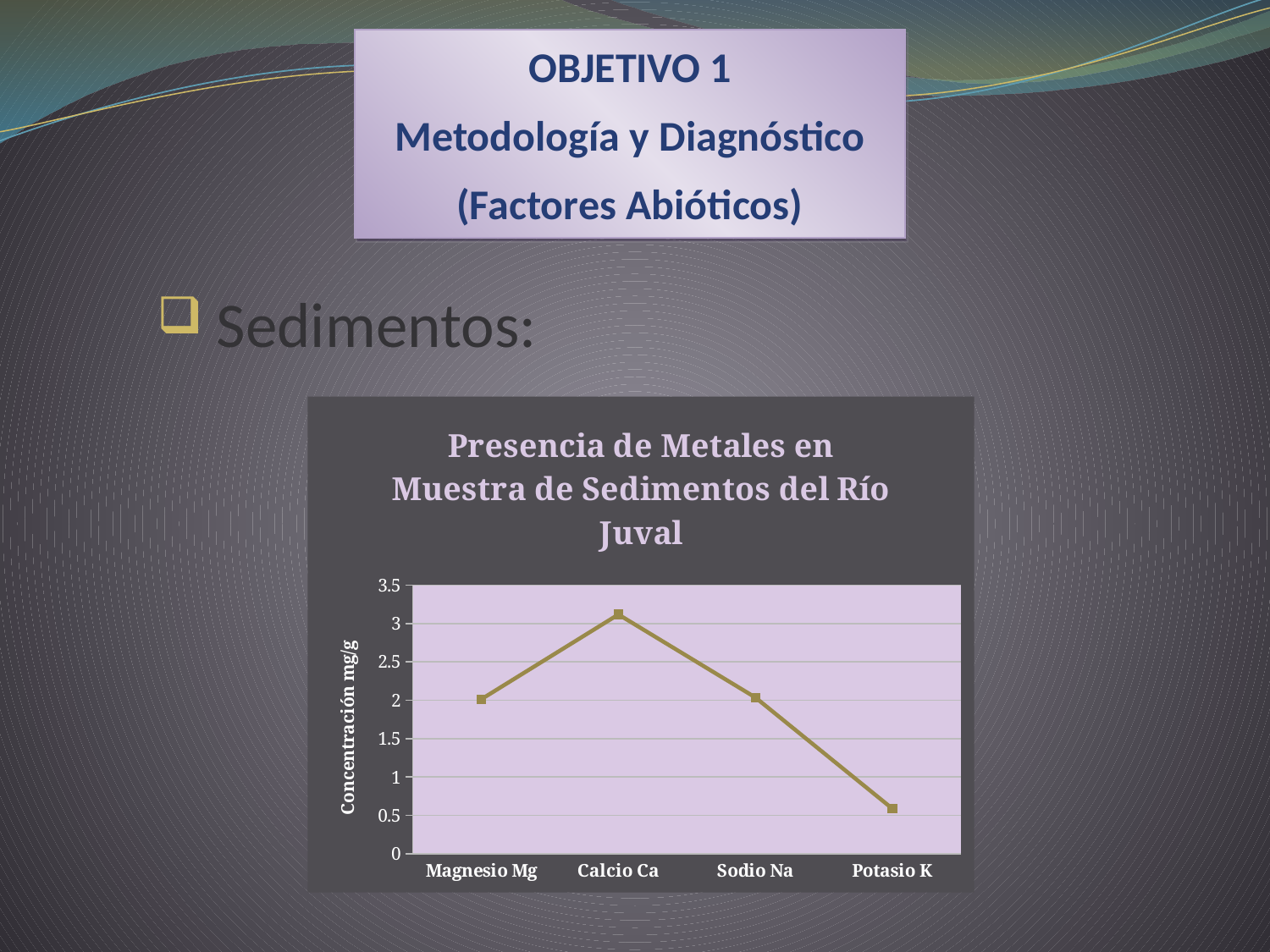
Is the value for Magnesio Mg greater or less than 1.5? greater Is the value for Calcio Ca greater or less than 3? greater What is the title of the chart? Presencia de Metales en Muestra de Sedimentos del Río Juval Which metal has the highest concentration? Calcio Ca Do the values rise or fall along the x axis from Calcio Ca to Potasio K? fall What is the label of the vertical axis? Concentración mg/g What kind of chart is shown on the slide? line chart Is the value for Potasio K greater or less than 1? less Which metal has the lowest concentration? Potasio K How many metals are plotted on the x axis? 4 Which has a larger concentration, Calcio Ca or Sodio Na? Calcio Ca